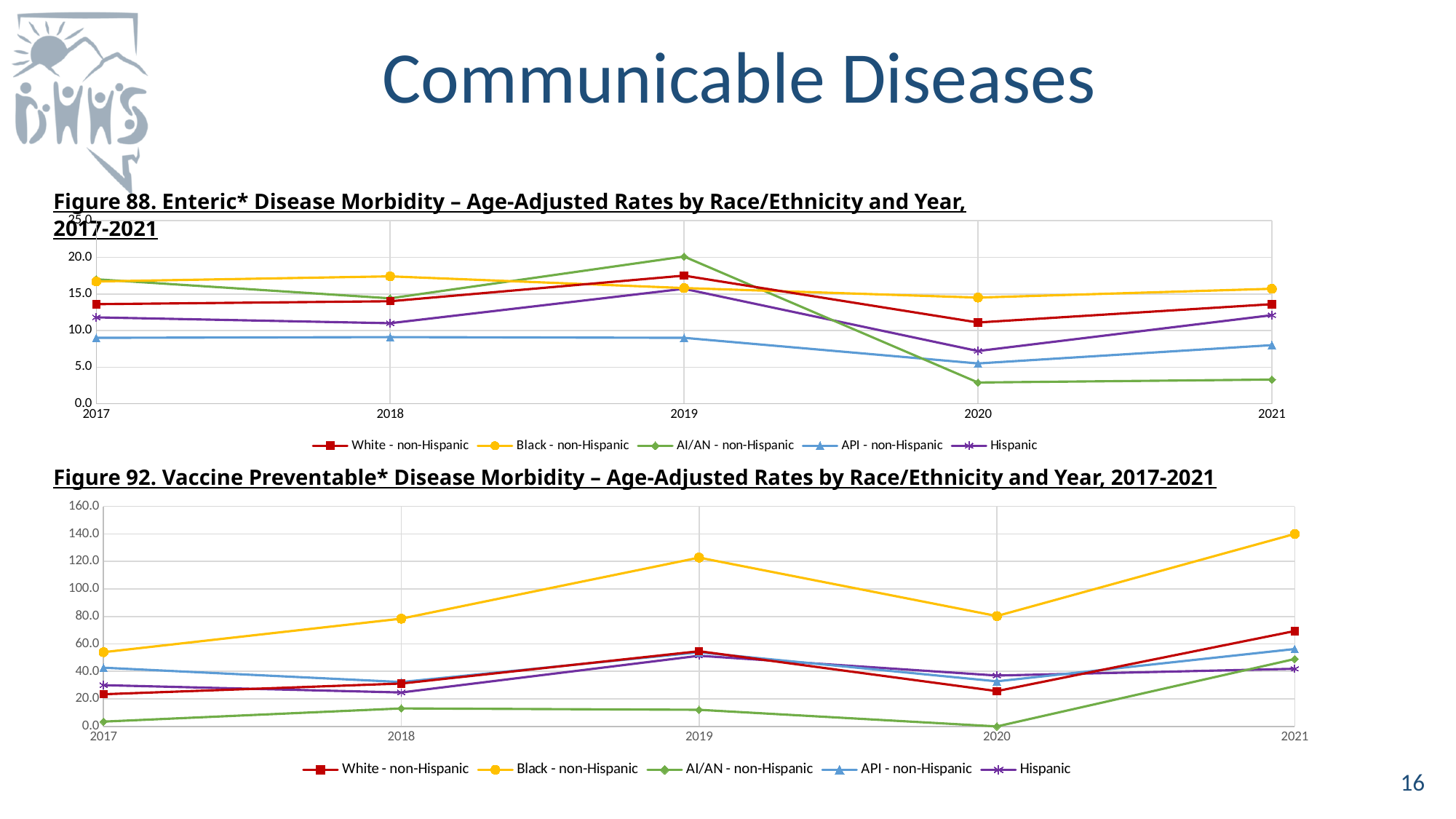
In Figure 92 (Vaccine Preventable Disease Morbidity), does the Black - non-Hispanic rate rise or fall from 2019 to 2020? Fall How many years are plotted along the x axis of Figure 88 (Enteric Disease Morbidity)? 5 In Figure 92 (Vaccine Preventable Disease Morbidity), which race/ethnicity has the lowest rate in 2020? AI/AN - non-Hispanic In Figure 92 (Vaccine Preventable Disease Morbidity), which race/ethnicity has the highest rate in 2021? Black - non-Hispanic In Figure 88 (Enteric Disease Morbidity), which race/ethnicity has the lowest rate in 2020? AI/AN - non-Hispanic In Figure 92 (Vaccine Preventable Disease Morbidity), which is larger in 2017: the value for Black - non-Hispanic or the value for White - non-Hispanic? Black - non-Hispanic In Figure 88 (Enteric Disease Morbidity), which race/ethnicity has the highest rate in 2019? AI/AN - non-Hispanic In Figure 92 (Vaccine Preventable Disease Morbidity), is the 2021 value for Black - non-Hispanic greater or less than 120.0? greater What kind of chart is Figure 88 (Enteric Disease Morbidity)? Line chart In Figure 88 (Enteric Disease Morbidity), is the 2017 value for API - non-Hispanic greater or less than 10.0? less How many series does the legend of Figure 92 (Vaccine Preventable Disease Morbidity) list? 5 In Figure 88 (Enteric Disease Morbidity), is the 2019 value for AI/AN - non-Hispanic greater or less than 15.0? greater